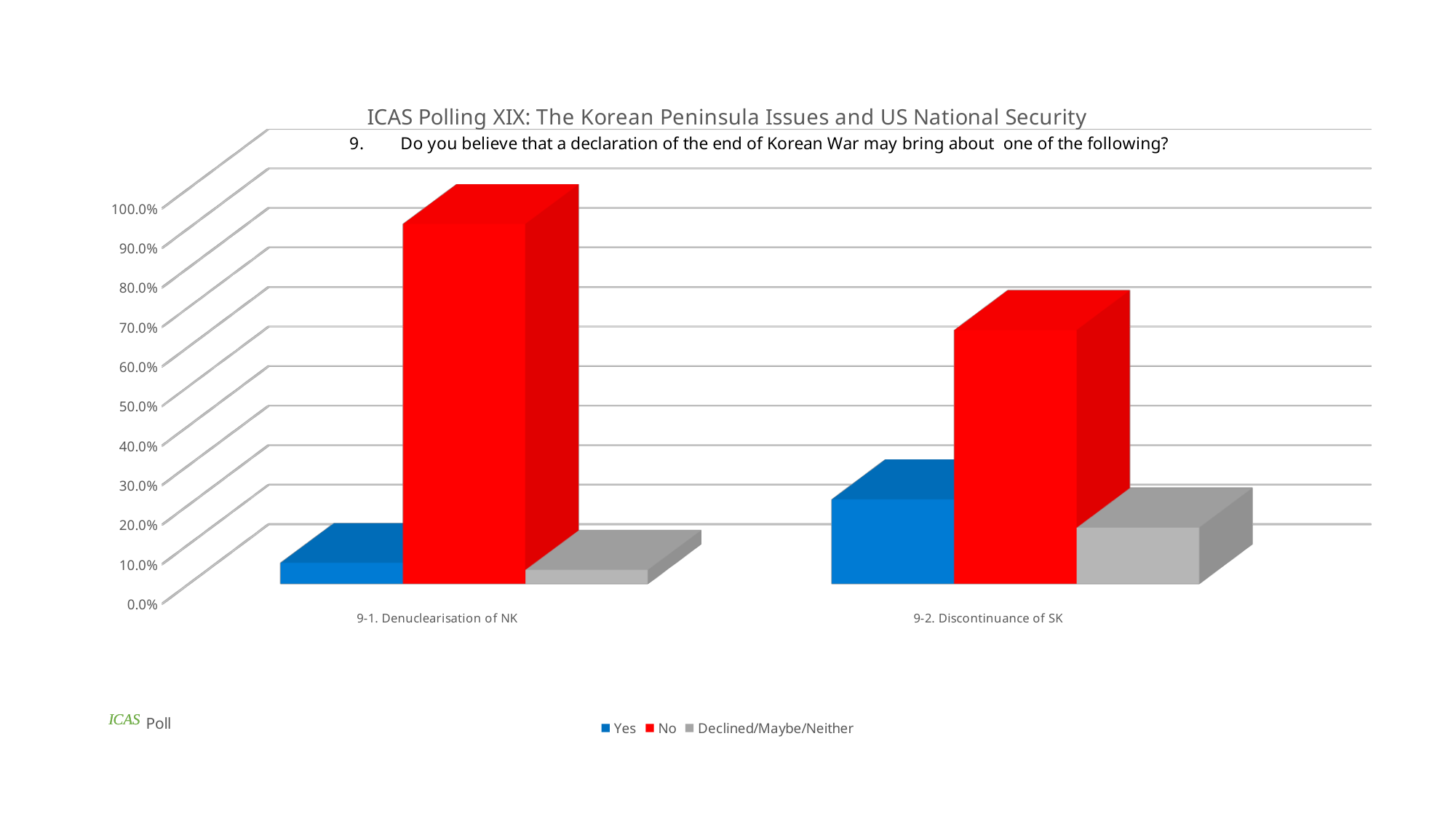
What kind of chart is shown on the slide? bar chart How many series does the legend list? 3 For 9-2. Discontinuance of SK, which is larger: Yes or Declined/Maybe/Neither? Yes Which response has the highest value for 9-2. Discontinuance of SK? No What colour represents the No series? red Is the value for No in 9-1. Denuclearisation of NK greater or less than 50.0%? greater Is the value for No higher for 9-1. Denuclearisation of NK or for 9-2. Discontinuance of SK? 9-1. Denuclearisation of NK Which response has the highest value for 9-1. Denuclearisation of NK? No Which response has the lowest value for 9-2. Discontinuance of SK? Declined/Maybe/Neither Is the value for Yes in 9-1. Denuclearisation of NK greater or less than 20.0%? less How many categories are shown on the x axis? 2 Is the value for No in 9-2. Discontinuance of SK greater or less than 40.0%? greater